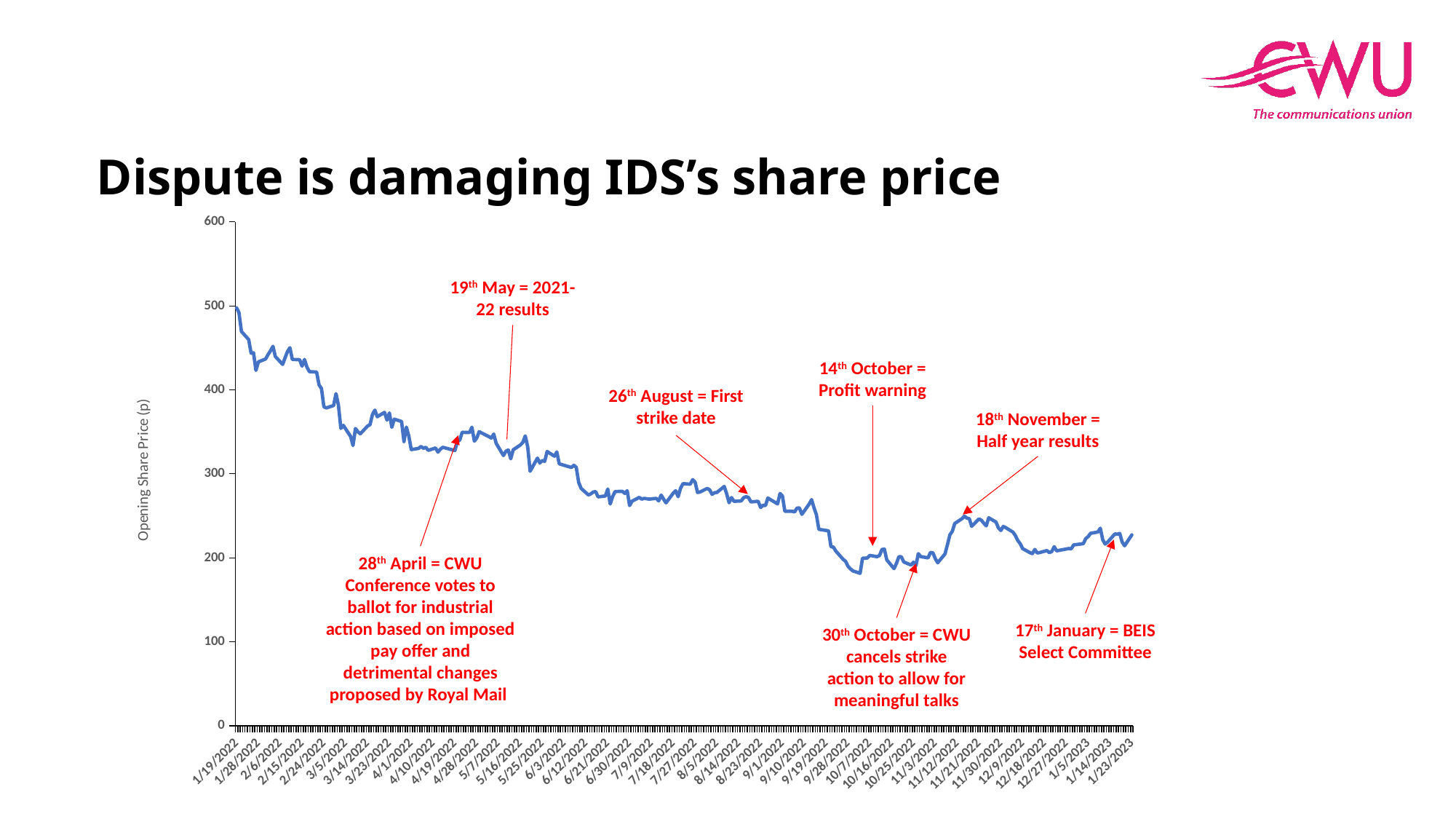
Is the opening share price on 1/19/2022 greater or less than 400? greater Is the opening share price on 1/23/2023 greater or less than 300? less Is the opening share price on 5/7/2022 greater or less than 300? greater What is the label of the vertical axis? Opening Share Price (p) On which date shown on the x axis is the opening share price at its highest? 1/19/2022 Overall, does the opening share price rise or fall from 1/19/2022 to 1/23/2023? fall What kind of chart is shown on the slide? line chart How many lines are plotted on the chart? 1 According to the annotation, what event is marked on 14th October? Profit warning Is the opening share price higher on 1/19/2022 or on 1/23/2023? 1/19/2022